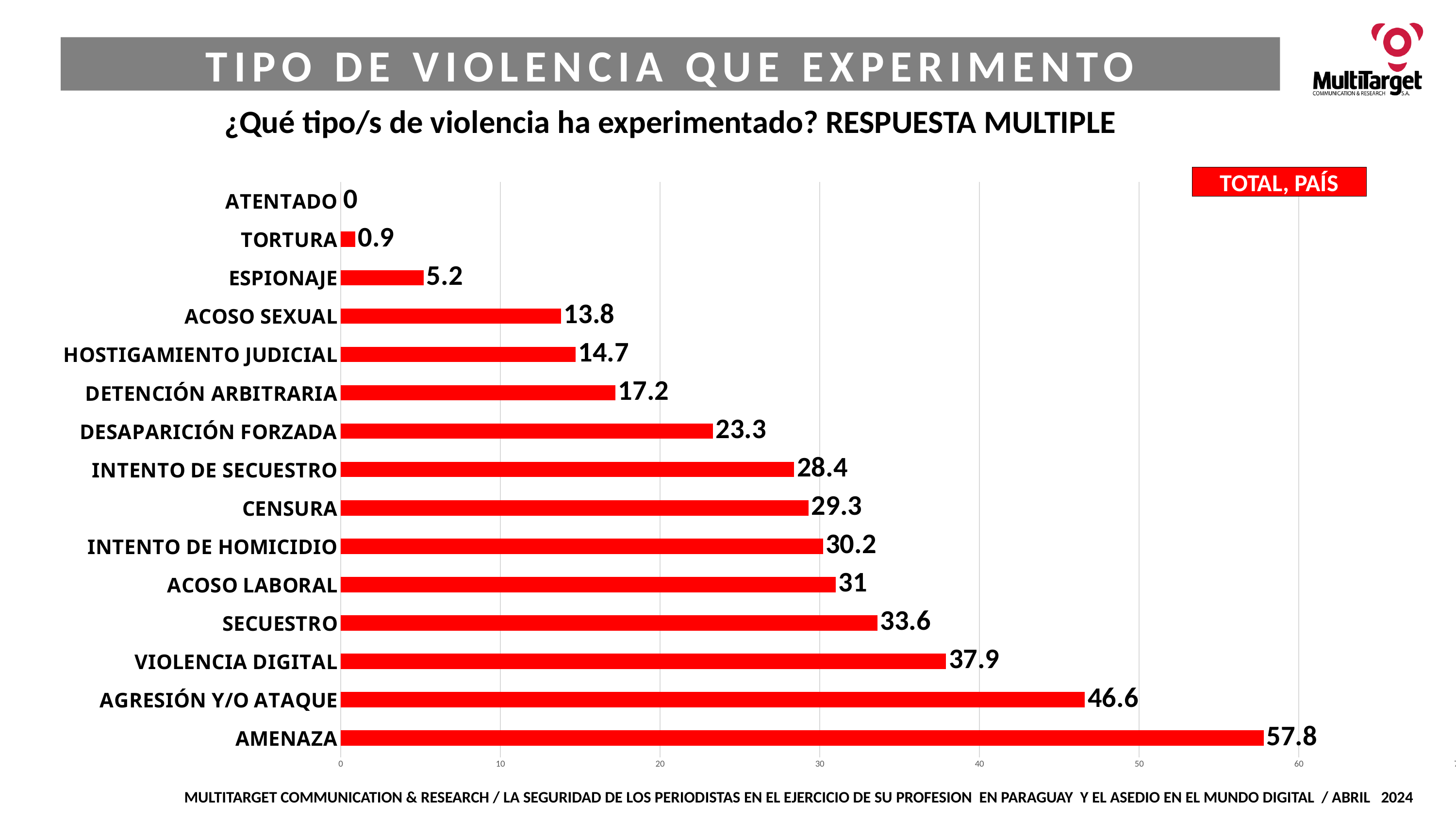
Which category has the highest value? AMENAZA What is the value for VIOLENCIA DIGITAL? 37.9 What is the value for HOSTIGAMIENTO JUDICIAL? 14.7 Is the value for AGRESIÓN Y/O ATAQUE greater or less than 40? greater What is the legend entry shown for the series? TOTAL, PAÍS What kind of chart is shown on the slide? bar chart Which is larger, the value for DESAPARICIÓN FORZADA or the value for DETENCIÓN ARBITRARIA? DESAPARICIÓN FORZADA How many categories are shown in the chart? 15 What is the difference between the values for SECUESTRO and INTENTO DE SECUESTRO? 5.2 Which category has the lowest value? ATENTADO What is the difference between the values for AMENAZA and AGRESIÓN Y/O ATAQUE? 11.2 What is the value for AMENAZA? 57.8